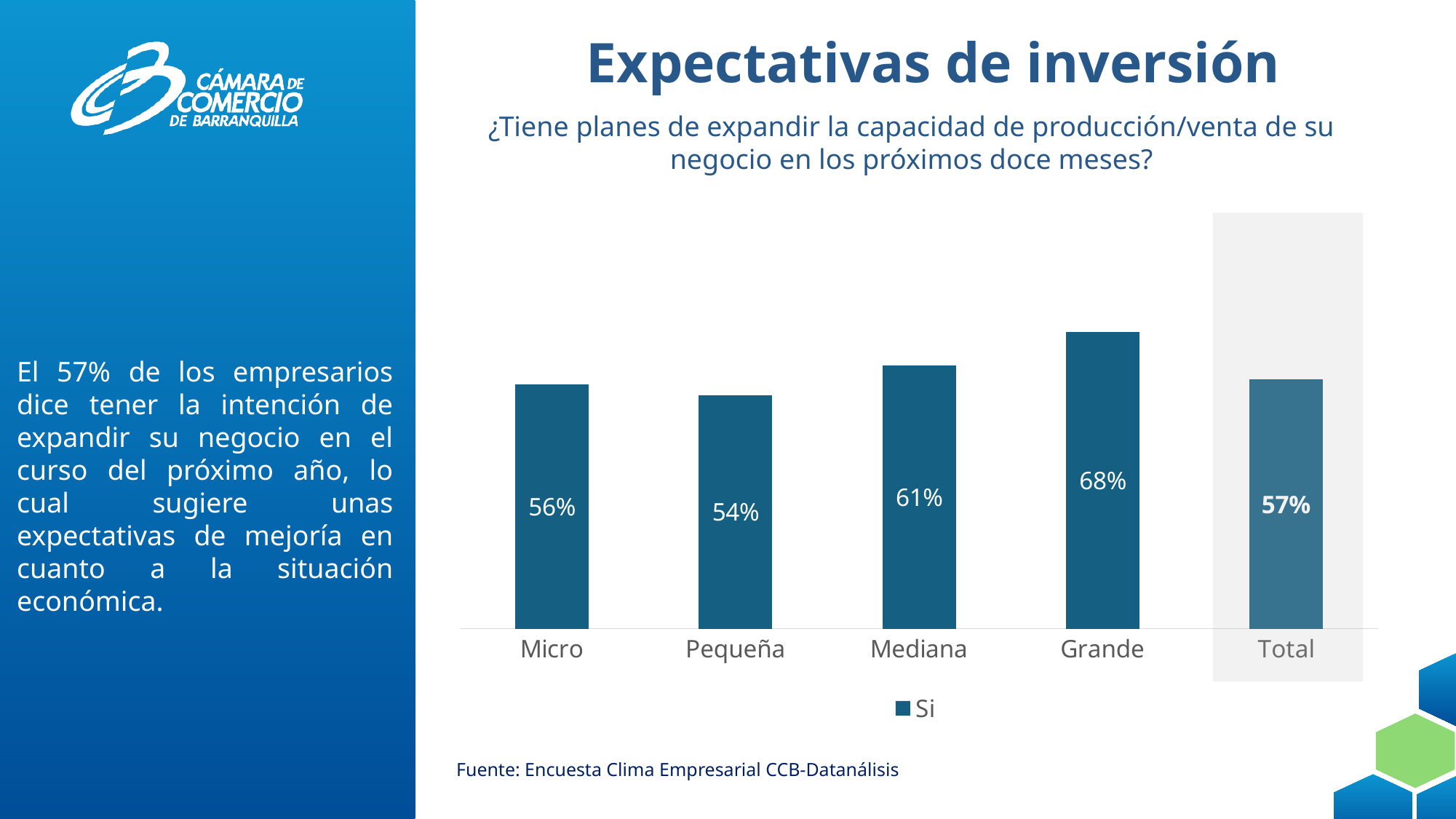
How many categories are shown on the x axis? 5 What is the difference between the values for Grande and Micro? 12% What kind of chart is shown on the slide? Bar chart Which category has the lowest value? Pequeña What is the only series listed in the legend? Si What is the value for Grande? 68% What is the value for Total? 57% Which category has the highest value? Grande What is the value for Pequeña? 54% What is the value for Micro? 56% What is the value for Mediana? 61% Which is larger, the value for Mediana or the value for Pequeña? Mediana